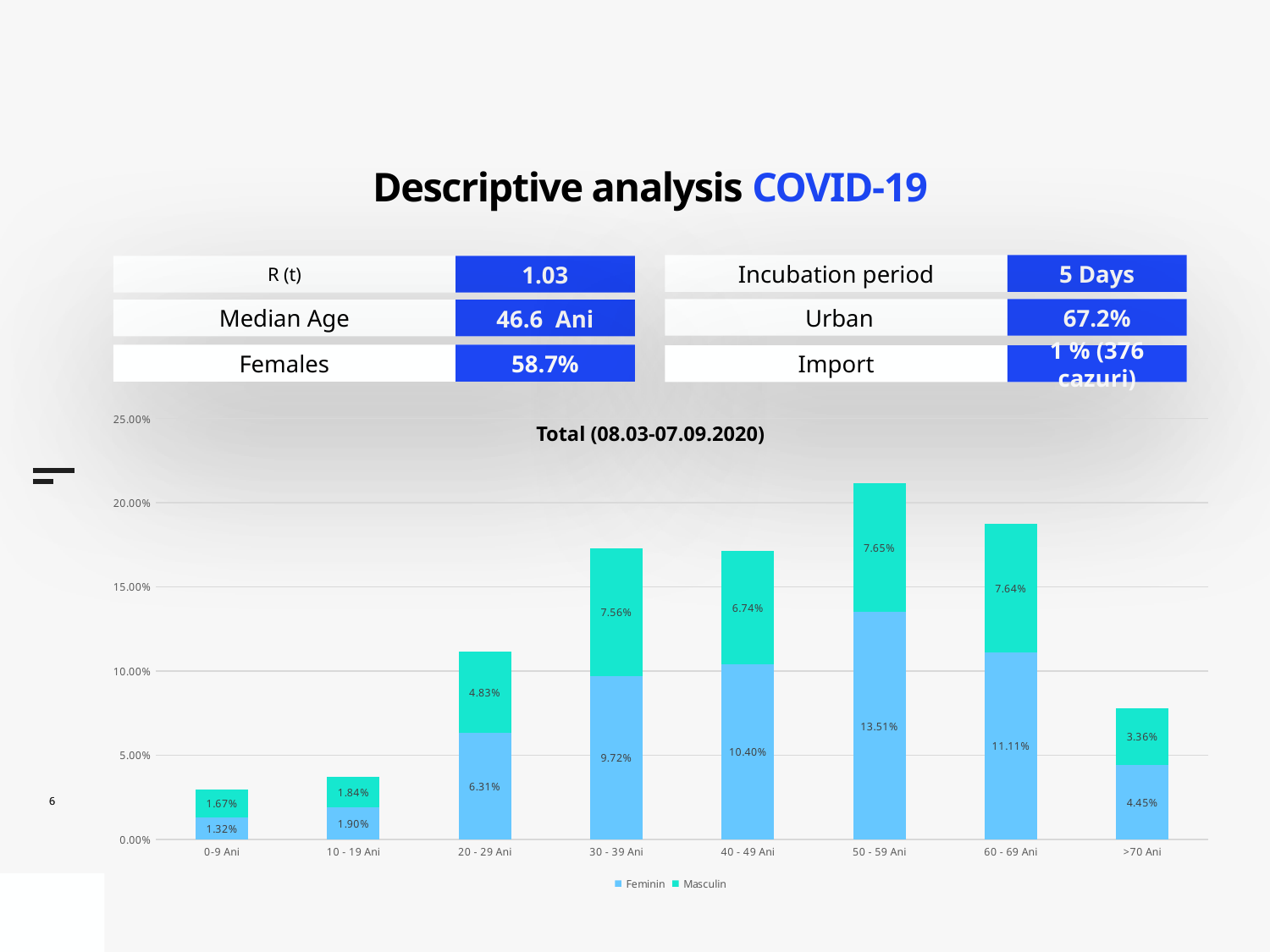
How many age groups are shown on the x axis? 8 Which is larger, the Feminin value for 40 - 49 Ani or for 30 - 39 Ani? 40 - 49 Ani What kind of chart is shown on the slide? stacked bar chart What is the total of the stacked bar for the 0-9 Ani age group? 2.99% What is the Feminin value for the 50 - 59 Ani age group? 13.51% What is the difference between the Feminin values for 50 - 59 Ani and 60 - 69 Ani? 2.40% How many series does the legend list? 2 Which age group has the highest Feminin value? 50 - 59 Ani What is the Feminin value for the >70 Ani age group? 4.45% Which age group has the lowest Feminin value? 0-9 Ani Is the total stacked value for the 50 - 59 Ani bar greater or less than 20.00%? greater What is the Masculin value for the 20 - 29 Ani age group? 4.83%